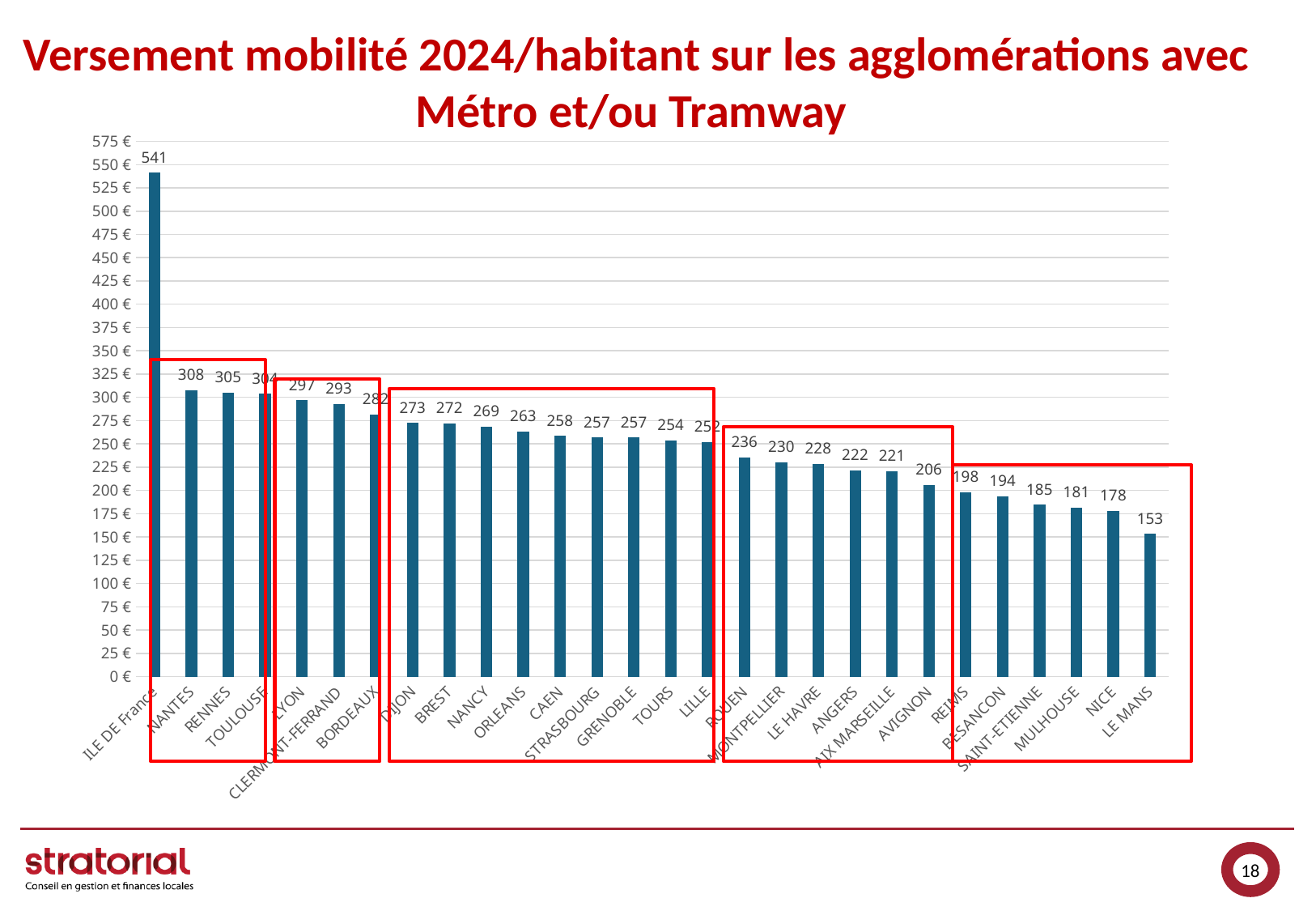
What is the value for NANTES? 308 What is the value for STRASBOURG? 257 Do the values rise or fall from left to right along the x axis? fall What is the value for LYON? 297 Which category has the lowest value? LE MANS Which category has the highest value? ILE DE France Is the value for ROUEN greater or less than 250 €? less Which is larger, the value for BORDEAUX or the value for DIJON? BORDEAUX What is the value for AVIGNON? 206 What is the difference between the values for ILE DE France and NANTES? 233 How many categories are shown on the x axis? 28 What kind of chart is this? bar chart